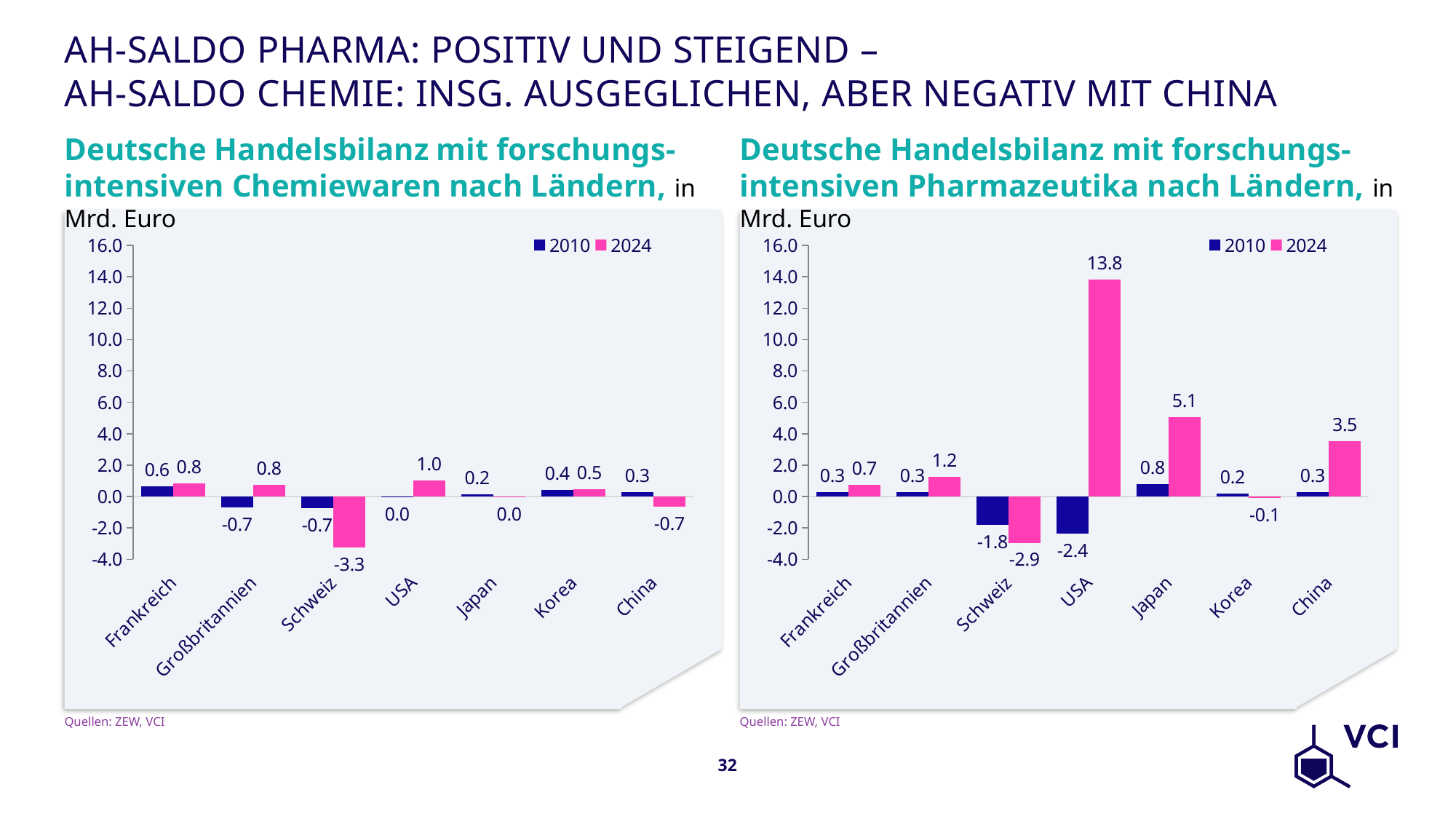
In the left chart (Chemiewaren), which country has the lowest 2024 value? Schweiz How many series does the legend of the right chart (Pharmazeutika) list? 2 In the left chart (Chemiewaren), what is the difference between the 2024 values for USA and China? 1.7 In the right chart (Pharmazeutika), what is the 2024 value for USA? 13.8 In the right chart (Pharmazeutika), is the 2024 value for USA greater or less than 12.0? greater What kind of chart is the left chart (Chemiewaren)? Bar chart In the right chart (Pharmazeutika), is the 2024 value for Japan larger or the 2024 value for China? Japan In the left chart (Chemiewaren), what is the 2024 value for Schweiz? -3.3 In the right chart (Pharmazeutika), what is the difference between the 2024 and 2010 values for USA? 16.2 In the right chart (Pharmazeutika), what is the 2010 value for Japan? 0.8 How many countries are shown on the x axis of the left chart (Chemiewaren)? 7 In the right chart (Pharmazeutika), which country has the highest 2024 value? USA